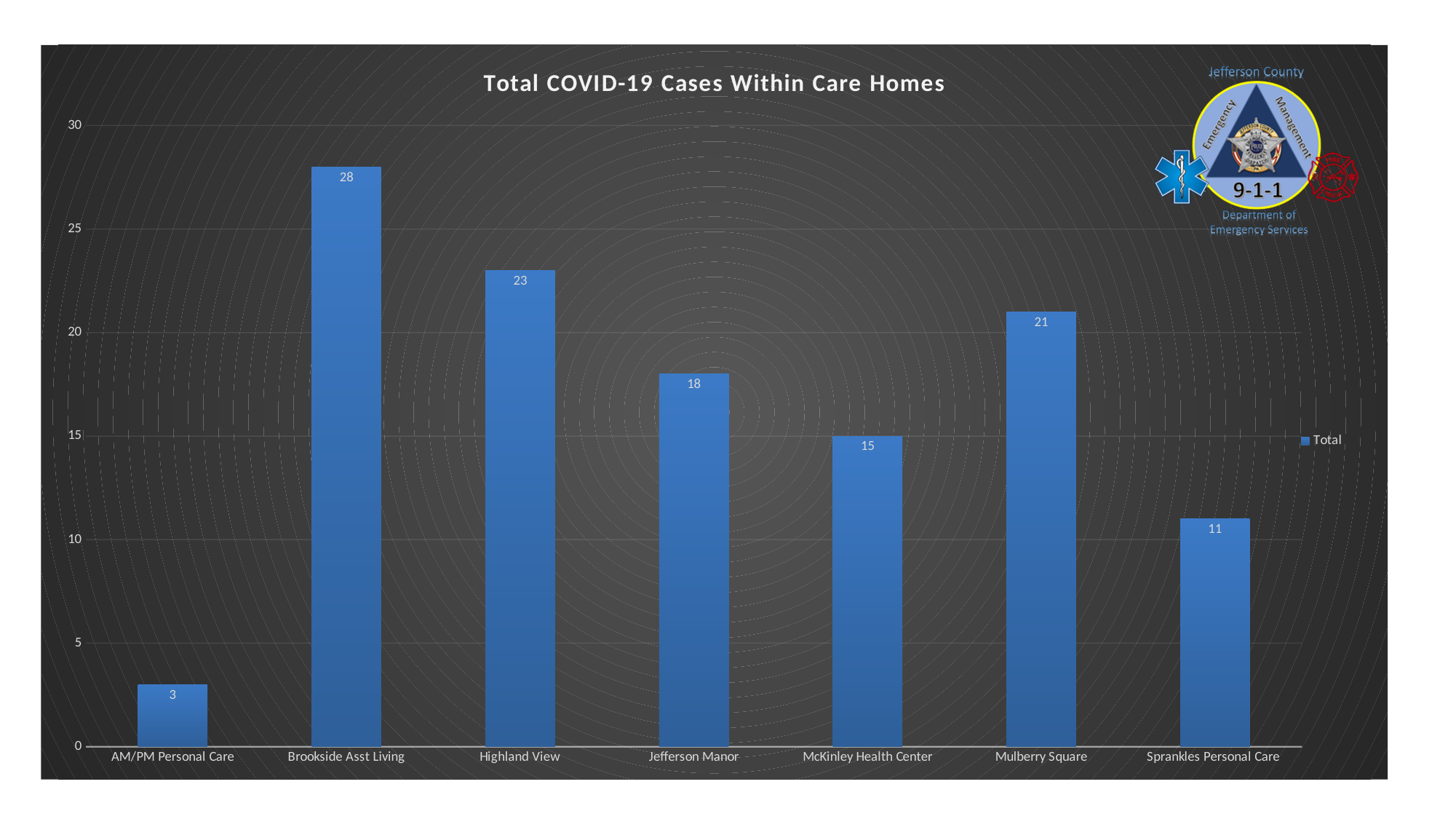
How many series does the legend list? 1 What is the title of the chart? Total COVID-19 Cases Within Care Homes What is the total number of COVID-19 cases at Sprankles Personal Care? 11 What is the difference in cases between Highland View and McKinley Health Center? 8 Is the value for Highland View greater or less than 20? greater Which care home has the lowest number of COVID-19 cases? AM/PM Personal Care How many care homes are shown on the chart? 7 Which has more COVID-19 cases, Mulberry Square or Jefferson Manor? Mulberry Square What is the total number of COVID-19 cases at Jefferson Manor? 18 What kind of chart is shown on the slide? Bar chart What is the total number of COVID-19 cases at Brookside Asst Living? 28 Which care home has the highest number of COVID-19 cases? Brookside Asst Living